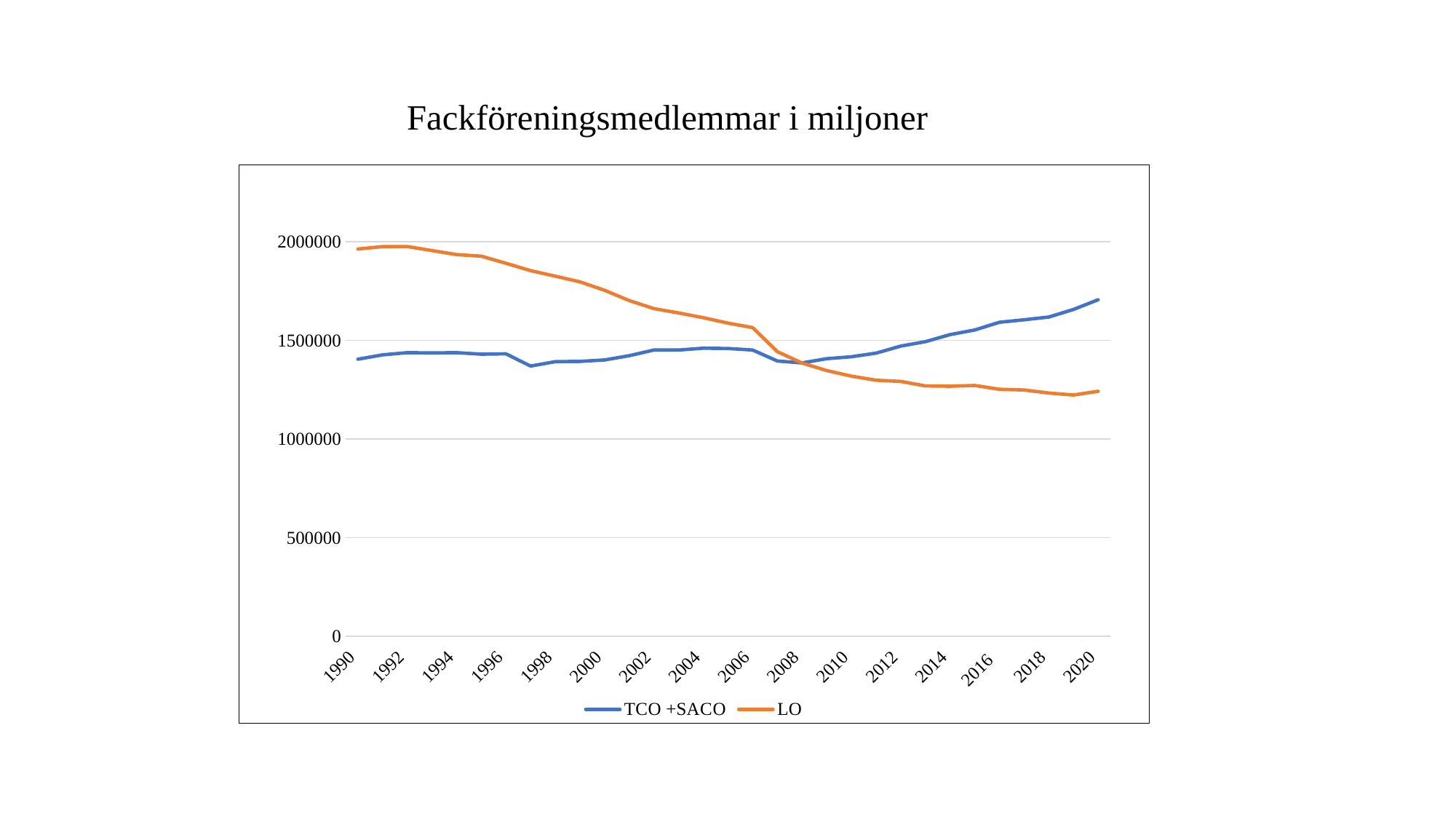
Is the value for LO in 2020 greater or less than 1500000? less Is the value for LO in 1990 greater or less than 1500000? greater In 2020, which series has the higher value, TCO +SACO or LO? TCO +SACO Is the value for TCO +SACO in 2020 greater or less than 1500000? greater How many year labels are shown on the x axis? 16 How many series does the legend list? 2 In 1990, which series has the higher value, TCO +SACO or LO? LO Does the TCO +SACO series rise or fall from 2008 to 2020? rise Which series is drawn in orange? LO What is the title of the chart? Fackföreningsmedlemmar i miljoner What kind of chart is shown on the slide? line chart Does the LO series rise or fall from 1990 to 2020? fall